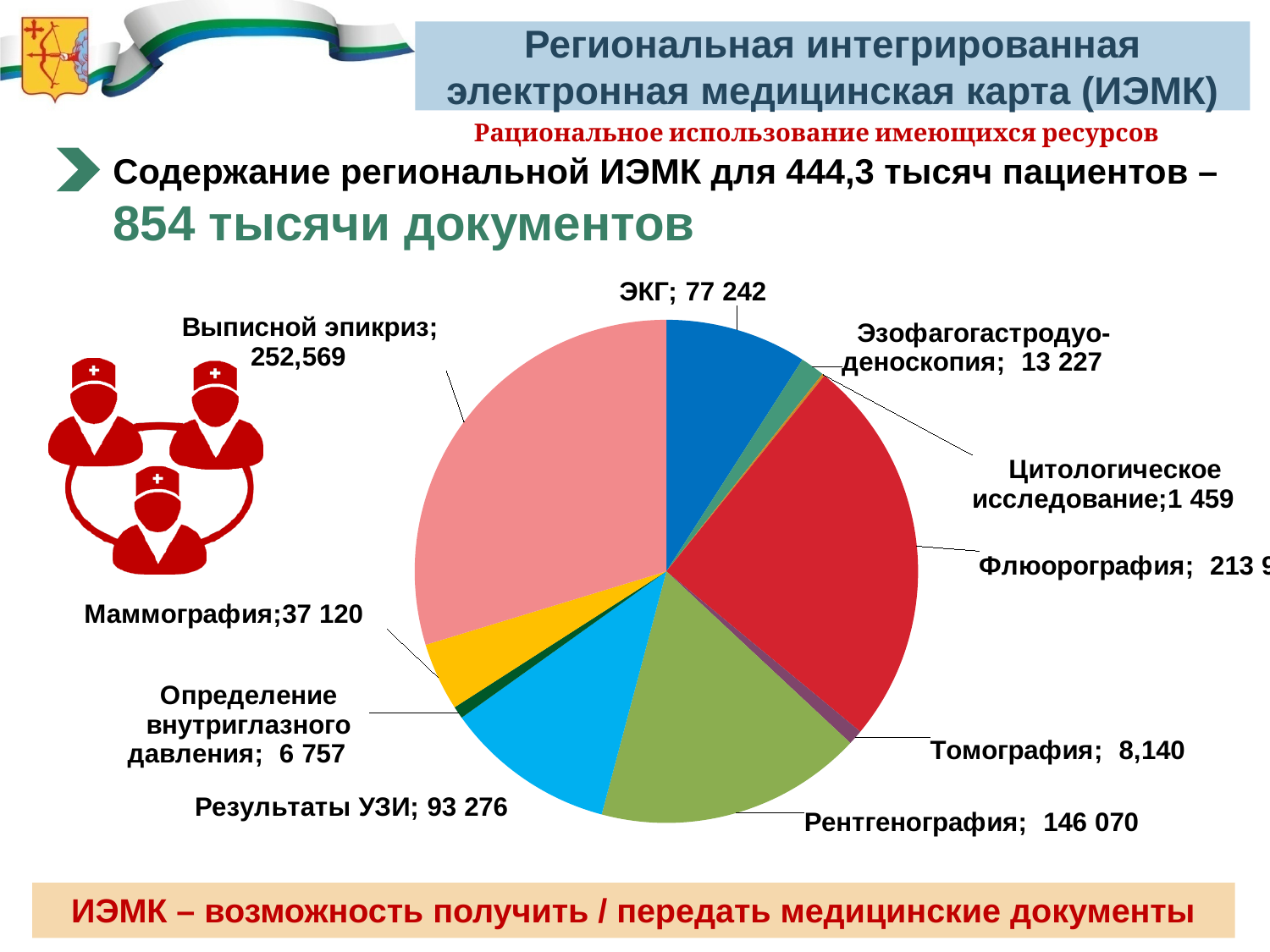
What is the value for Маммография in the pie chart? 37 120 What is the value for ЭКГ in the pie chart? 77 242 Which category has the largest slice in the pie chart? Выписной эпикриз What kind of chart is shown on the slide? pie chart What colour is the ЭКГ slice in the pie chart? blue How many slices does the pie chart have? 10 What is the difference between the values for ЭКГ and Маммография? 40 122 What is the value for Томография in the pie chart? 8,140 What is the value for Рентгенография in the pie chart? 146 070 Which category has the smallest slice in the pie chart? Цитологическое исследование Which is larger in the pie chart, Рентгенография or Результаты УЗИ? Рентгенография What is the value for Результаты УЗИ in the pie chart? 93 276